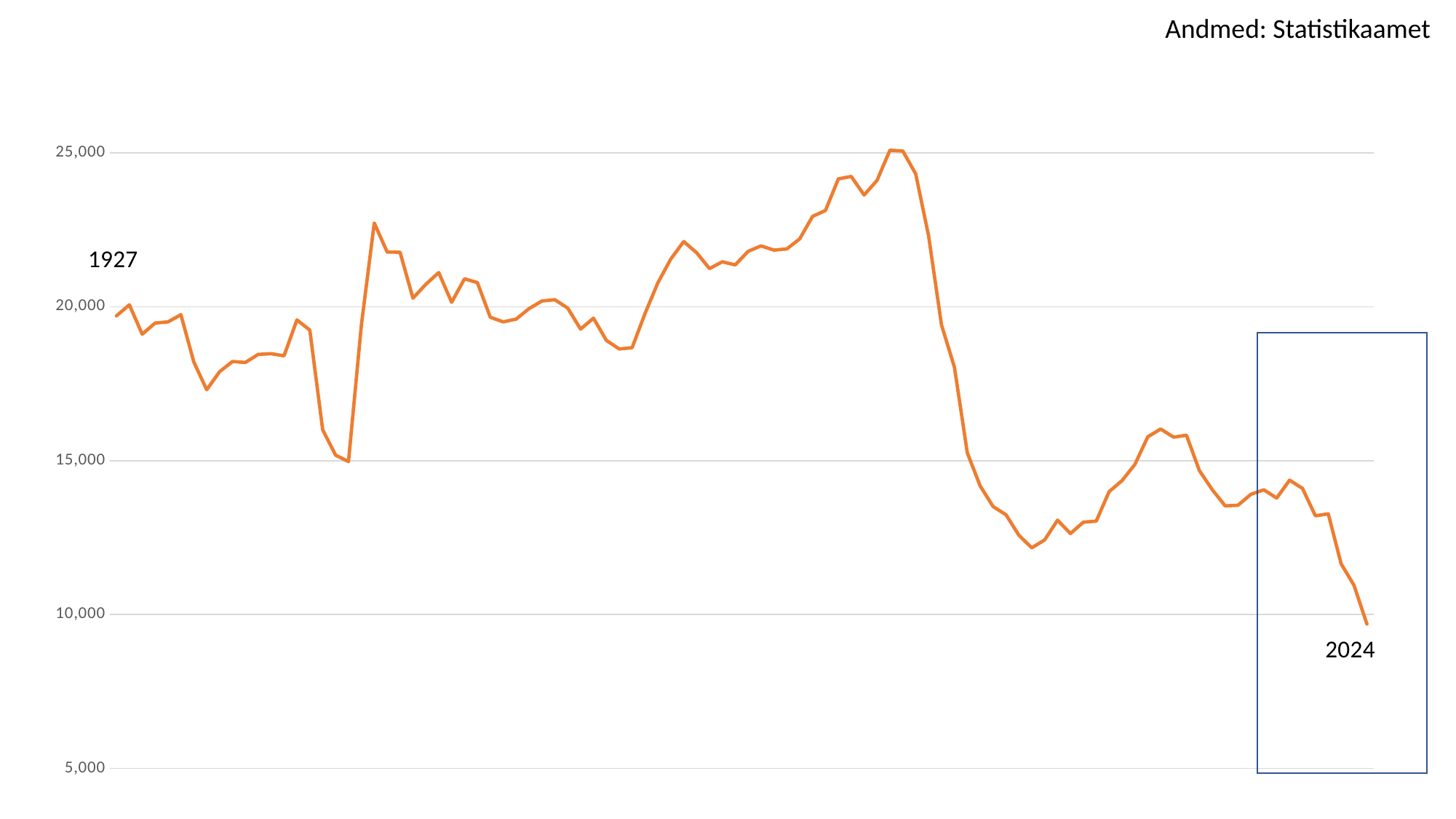
What is the highest tick value shown on the vertical axis? 25,000 Is the highest point on the line greater or less than 20,000? greater Overall, do the values rise or fall from 1927 to 2024? fall Which year label marks the start of the line? 1927 Is the value for 1927 greater or less than 15,000? greater What kind of chart is shown on the slide? line chart Do the values rise or fall over the final years inside the highlighted box? fall What is the lowest tick value shown on the vertical axis? 5,000 Which is larger, the value for 1927 or the value for 2024? 1927 Is the value for 2024 greater or less than 15,000? less